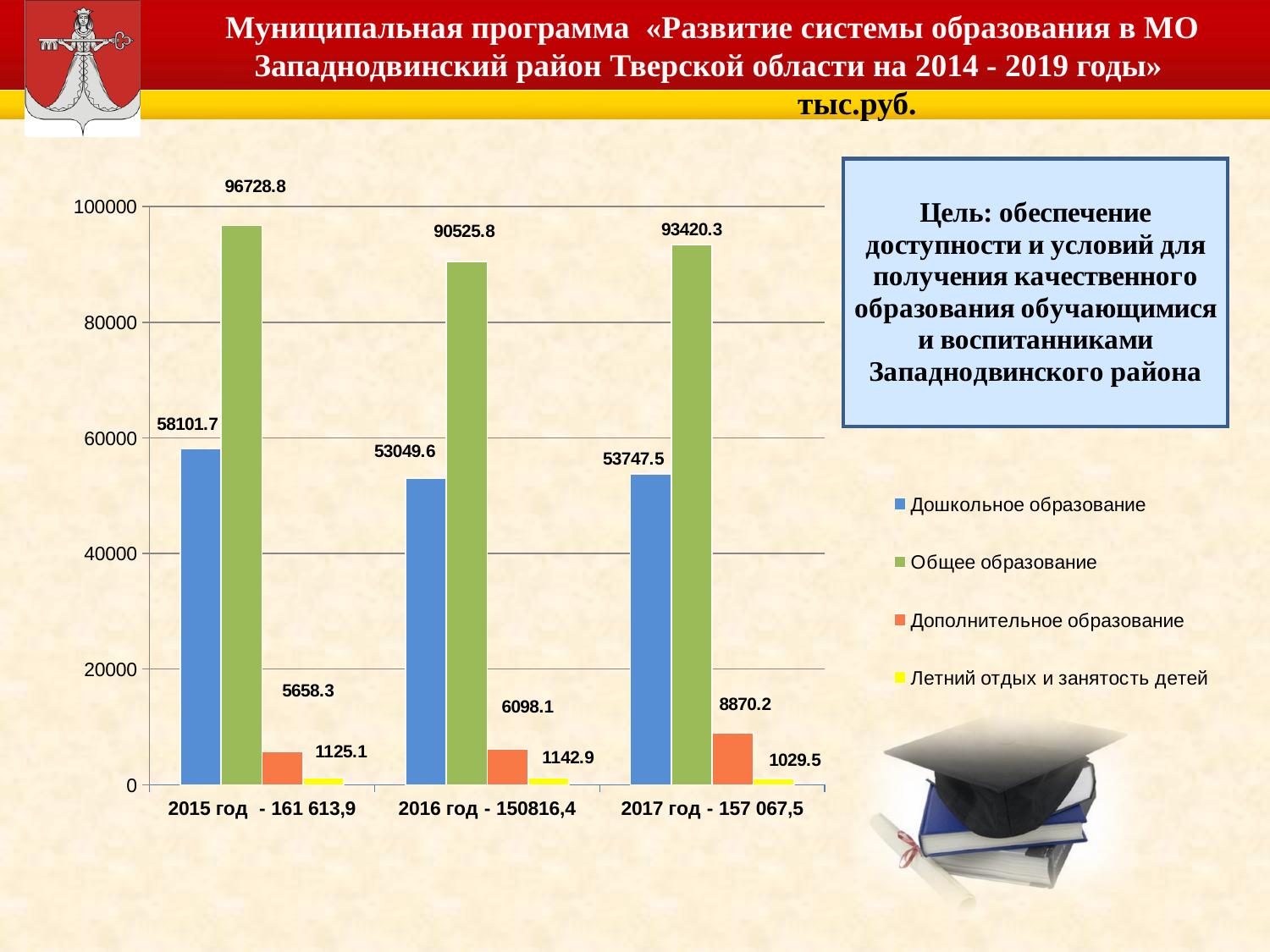
In which year is the value for Летний отдых и занятость детей the lowest? 2017 Is the value for Общее образование in 2017 greater or less than 80000? greater Which is larger: Дошкольное образование in 2015 or in 2017? 2015 What is the value for Летний отдых и занятость детей in 2016? 1142.9 What is the difference between the Общее образование values for 2015 and 2016? 6203.0 What kind of chart is shown on the slide? bar chart What is the value for Дополнительное образование in 2017? 8870.2 Do the values for Дополнительное образование rise or fall from 2015 to 2017? rise What is the value for Дошкольное образование in 2016? 53049.6 In which year is the value for Общее образование the highest? 2015 How many series does the legend list? 4 What is the value for Общее образование in 2015? 96728.8